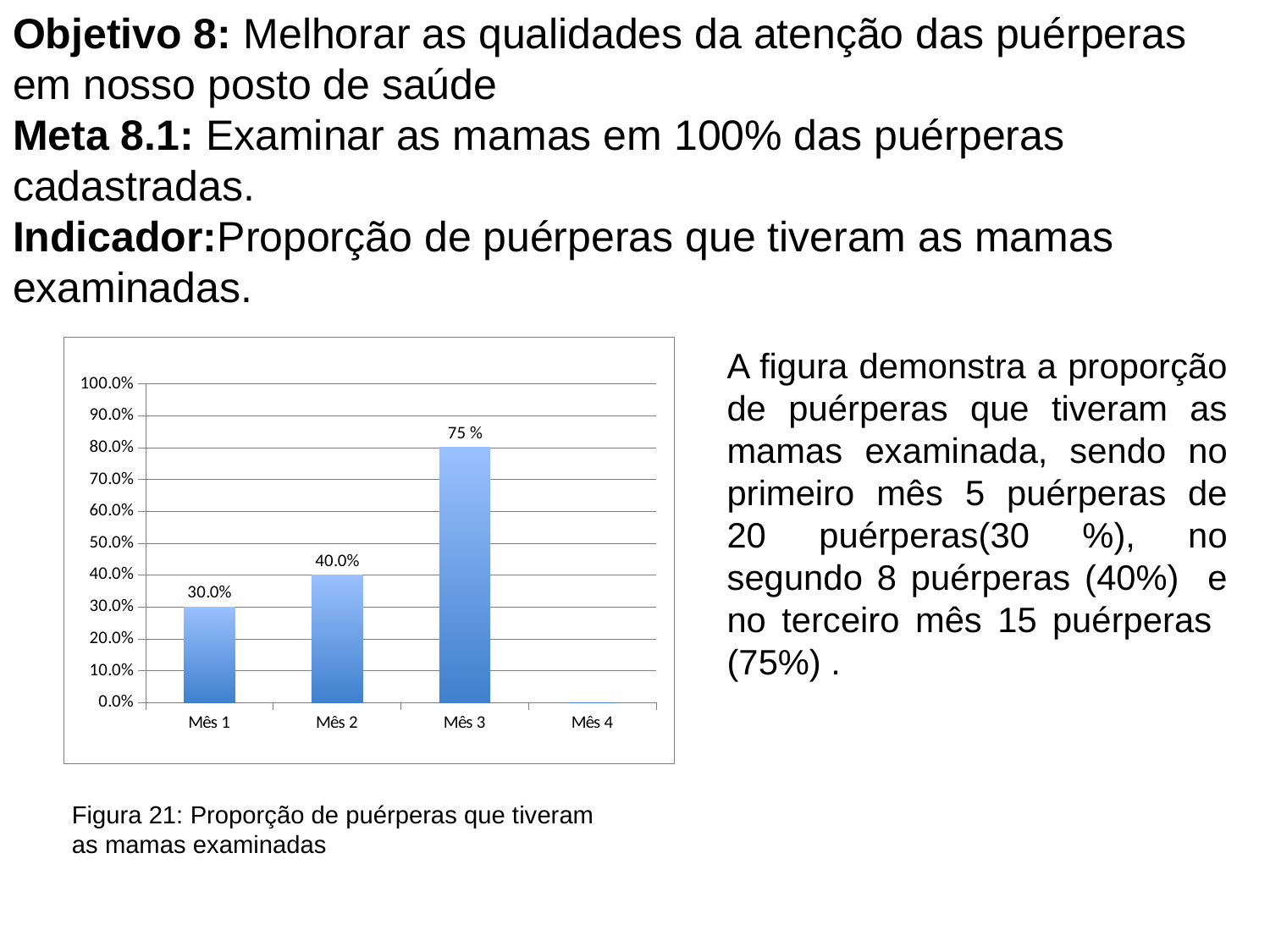
Do the values rise or fall from Mês 1 to Mês 3? rise Is the value for Mês 1 greater or less than 50.0%? less Which is larger, the value for Mês 1 or the value for Mês 2? Mês 2 What is the difference between the values for Mês 2 and Mês 1? 10.0% What kind of chart is shown on the slide? bar chart How many month categories are shown on the x axis? 4 Is the value for Mês 3 greater or less than 50.0%? greater What is the value shown for Mês 1? 30.0% Among Mês 1, Mês 2 and Mês 3, which month has the lowest value? Mês 1 Which month has the highest bar? Mês 3 What data label is shown above the bar for Mês 3? 75 % What is the value shown for Mês 2? 40.0%